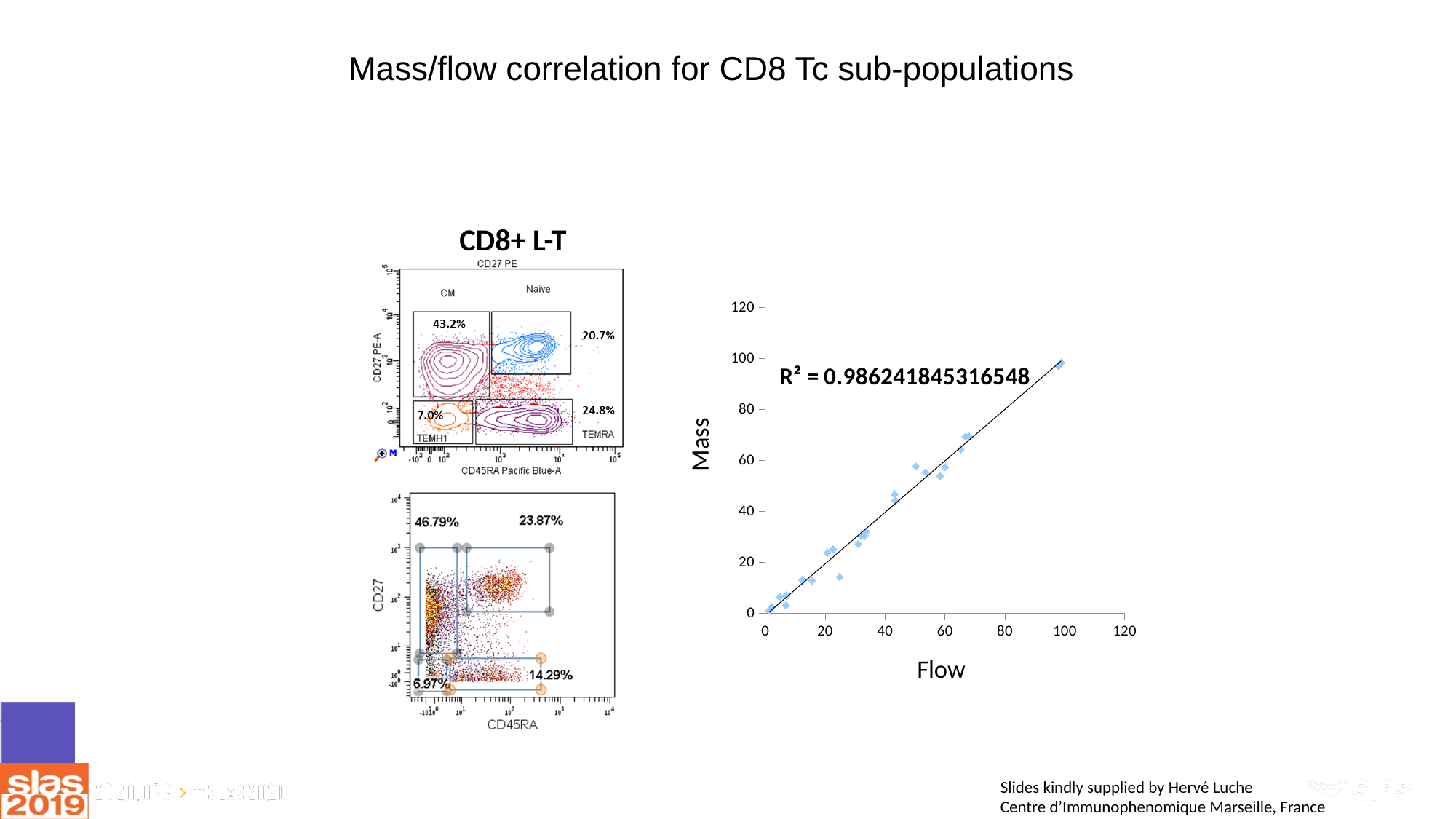
In the Mass versus Flow scatter chart, do the Mass values rise or fall as Flow increases? rise What kind of chart is the Mass versus Flow chart on the right of the slide? scatter chart In the upper CD8+ L-T flow cytometry plot, what percentage is shown for the Naive gate? 20.7% In the Mass versus Flow scatter chart, is the Mass value of the point at a Flow of about 67 greater or less than 60? greater In the Mass versus Flow scatter chart, what is the label of the vertical axis? Mass In the Mass versus Flow scatter chart, is the Mass value of the point with the highest Flow (near 100) greater or less than 80? greater In the Mass versus Flow scatter chart, is the Mass value of the point at a Flow of about 25 greater or less than 20? less In the upper CD8+ L-T flow cytometry plot, what percentage is shown for the TEMRA gate? 24.8% In the upper CD8+ L-T flow cytometry plot, which labelled gate has the lowest percentage? TEMH1 In the Mass versus Flow scatter chart, what R² value is printed on the chart? R² = 0.986241845316548 In the Mass versus Flow scatter chart, what is the highest tick value shown on the Flow axis? 120 In the upper CD8+ L-T flow cytometry plot, what percentage is shown for the CM gate? 43.2%